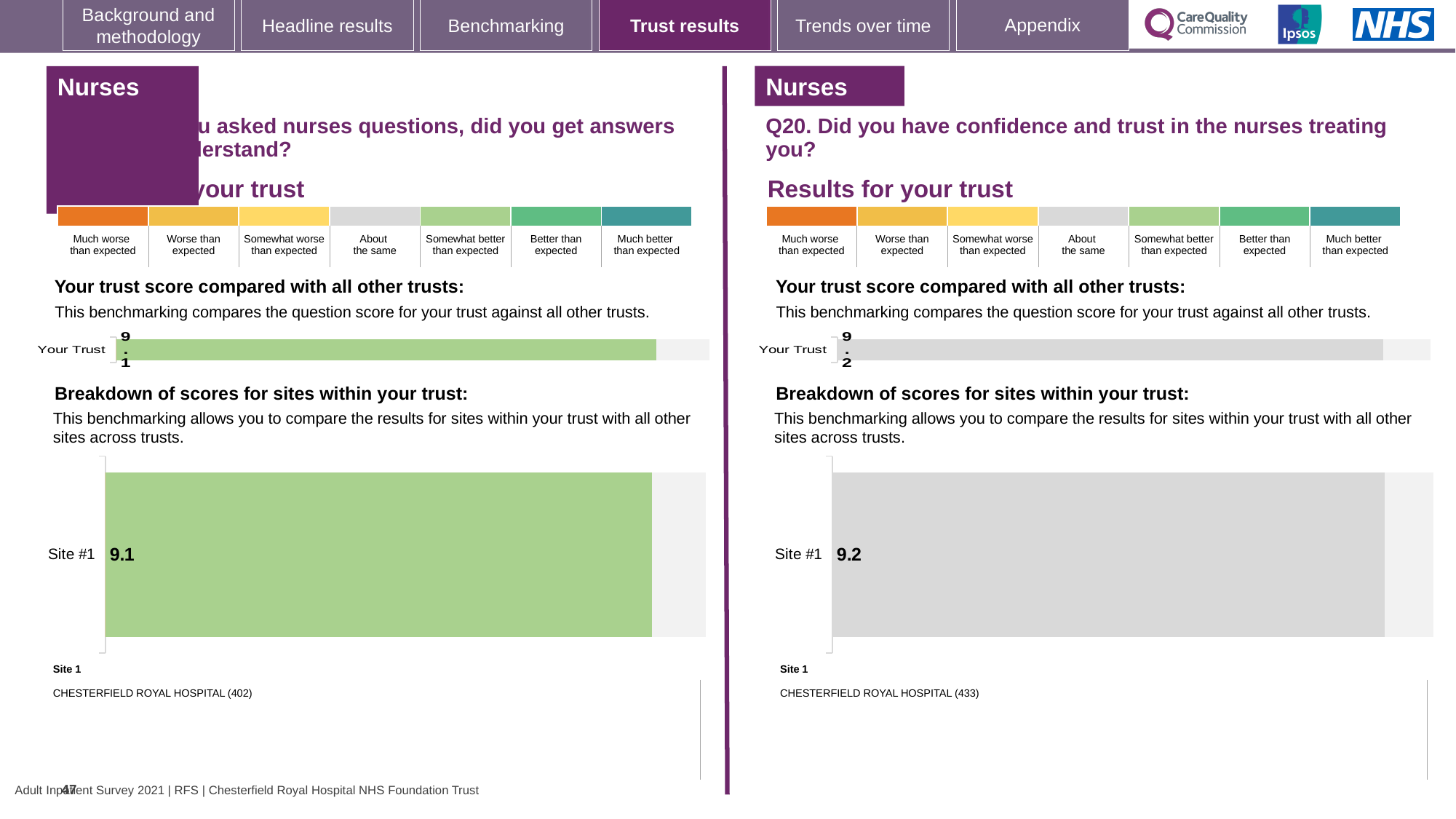
What is the difference between the Site #1 score on the right-hand side (Q20) and the Site #1 score on the left-hand side of the slide? 0.1 On the left-hand side of the slide, what is the score shown for Your Trust? 9.1 On the left-hand side of the slide, what is the score shown for Site #1? 9.1 On the right-hand side of the slide (Q20), what is the score shown for Site #1? 9.2 What kind of chart is used to show the Site #1 score on the right-hand side of the slide (Q20)? bar chart What colour is the Site #1 bar on the left-hand side of the slide? Green How many sites are shown in the breakdown of scores chart on the left-hand side of the slide? 1 Which is larger: the Site #1 score on the left-hand side of the slide or the Site #1 score on the right-hand side (Q20)? Right-hand side (Q20), 9.2 Which site name is listed as Site 1 on the right-hand side of the slide (Q20)? CHESTERFIELD ROYAL HOSPITAL (433) On the right-hand side of the slide (Q20), what is the score shown for Your Trust? 9.2 How many sites are shown in the breakdown of scores chart on the right-hand side of the slide (Q20)? 1 What colour is the Site #1 bar on the right-hand side of the slide (Q20)? Grey